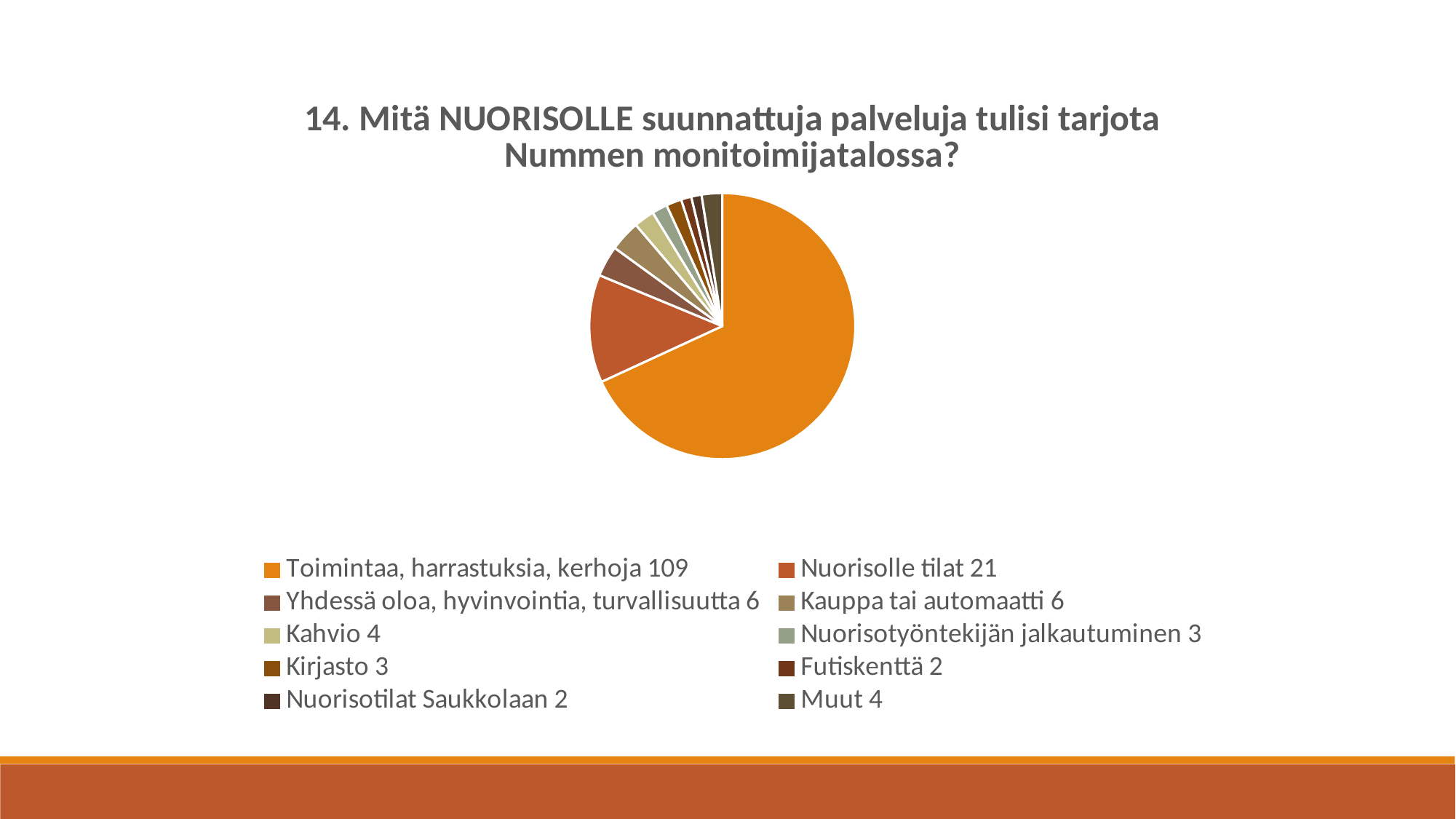
What is the value for Muut? 4 Which is larger, the value for Kauppa tai automaatti or the value for Kirjasto? Kauppa tai automaatti What is the value for Nuorisotyöntekijän jalkautuminen? 3 What is the value for Toimintaa, harrastuksia, kerhoja? 109 Which category has the largest slice of the pie? Toimintaa, harrastuksia, kerhoja What is the title of the chart? 14. Mitä NUORISOLLE suunnattuja palveluja tulisi tarjota Nummen monitoimijatalossa? What is the value for Kahvio? 4 What is the value for Nuorisolle tilat? 21 How many categories does the pie chart have? 10 What is the difference between the values for Toimintaa, harrastuksia, kerhoja and Nuorisolle tilat? 88 What is the difference between the values for Nuorisolle tilat and Yhdessä oloa, hyvinvointia, turvallisuutta? 15 What kind of chart is shown on the slide? pie chart